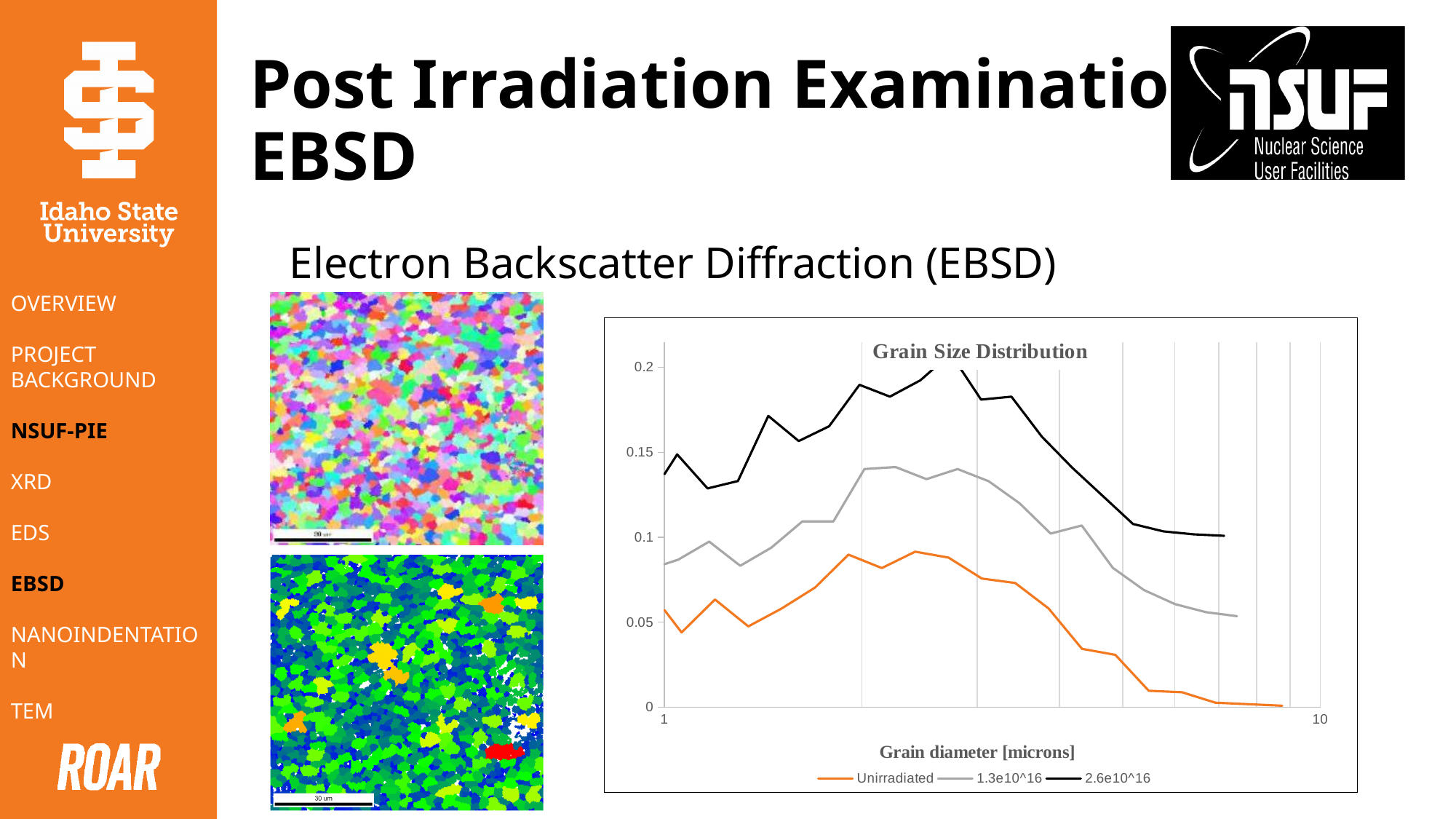
In the Grain Size Distribution chart, is the peak value of the 2.6e10^16 series greater or less than 0.15? greater What is the title of the chart on the slide? Grain Size Distribution In the Grain Size Distribution chart, is the peak value of the Unirradiated series greater or less than 0.1? less In the Grain Size Distribution chart, which series is higher at a grain diameter of 1 micron, 1.3e10^16 or Unirradiated? 1.3e10^16 In the Grain Size Distribution chart, which series has the highest values across the grain diameter range? 2.6e10^16 What is the x-axis label of the Grain Size Distribution chart? Grain diameter [microns] In the Grain Size Distribution chart, do the values of the Unirradiated series rise or fall toward the right end of the x axis (larger grain diameters)? fall In the Grain Size Distribution chart, is the peak value of the 1.3e10^16 series greater or less than 0.1? greater What type of chart is the Grain Size Distribution chart? line chart How many series does the legend of the Grain Size Distribution chart list? 3 In the Grain Size Distribution chart, which series has the lowest values across the grain diameter range? Unirradiated